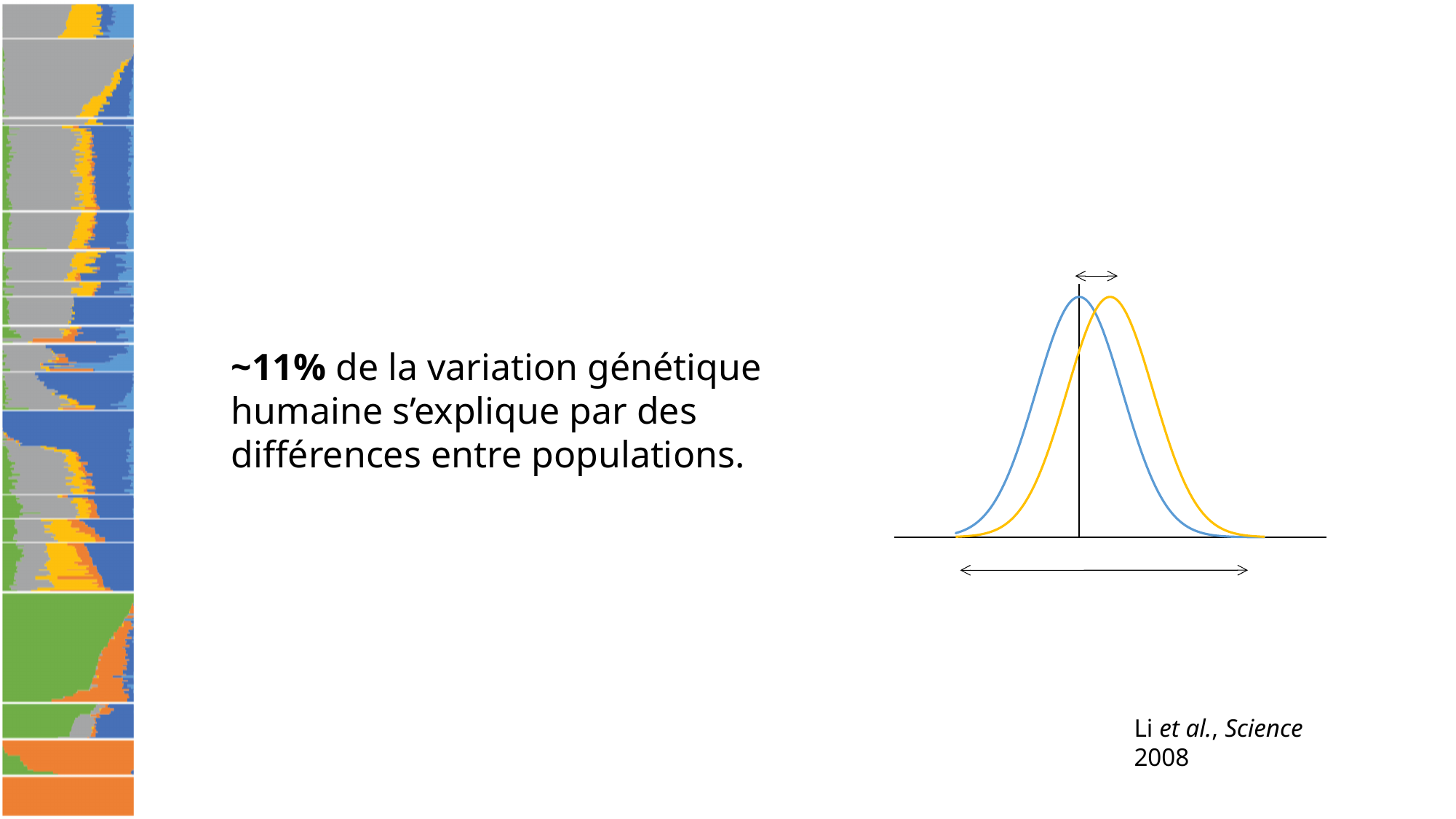
What percentage of human genetic variation does the slide text say is explained by differences between populations? ~11% What colours are the two curves on the chart on the right? blue and yellow What kind of chart is shown on the right side of the slide? line chart On the chart on the right, does the vertical line pass through the peak of the blue curve or the yellow curve? the blue curve On the chart on the right, which curve has its peak further to the right, the blue one or the yellow one? the yellow one What kind of chart is shown on the left side of the slide? stacked bar chart How many curves are plotted on the chart on the right side of the slide? 2 On the chart on the right, which curve has its peak further to the left, the blue one or the yellow one? the blue one